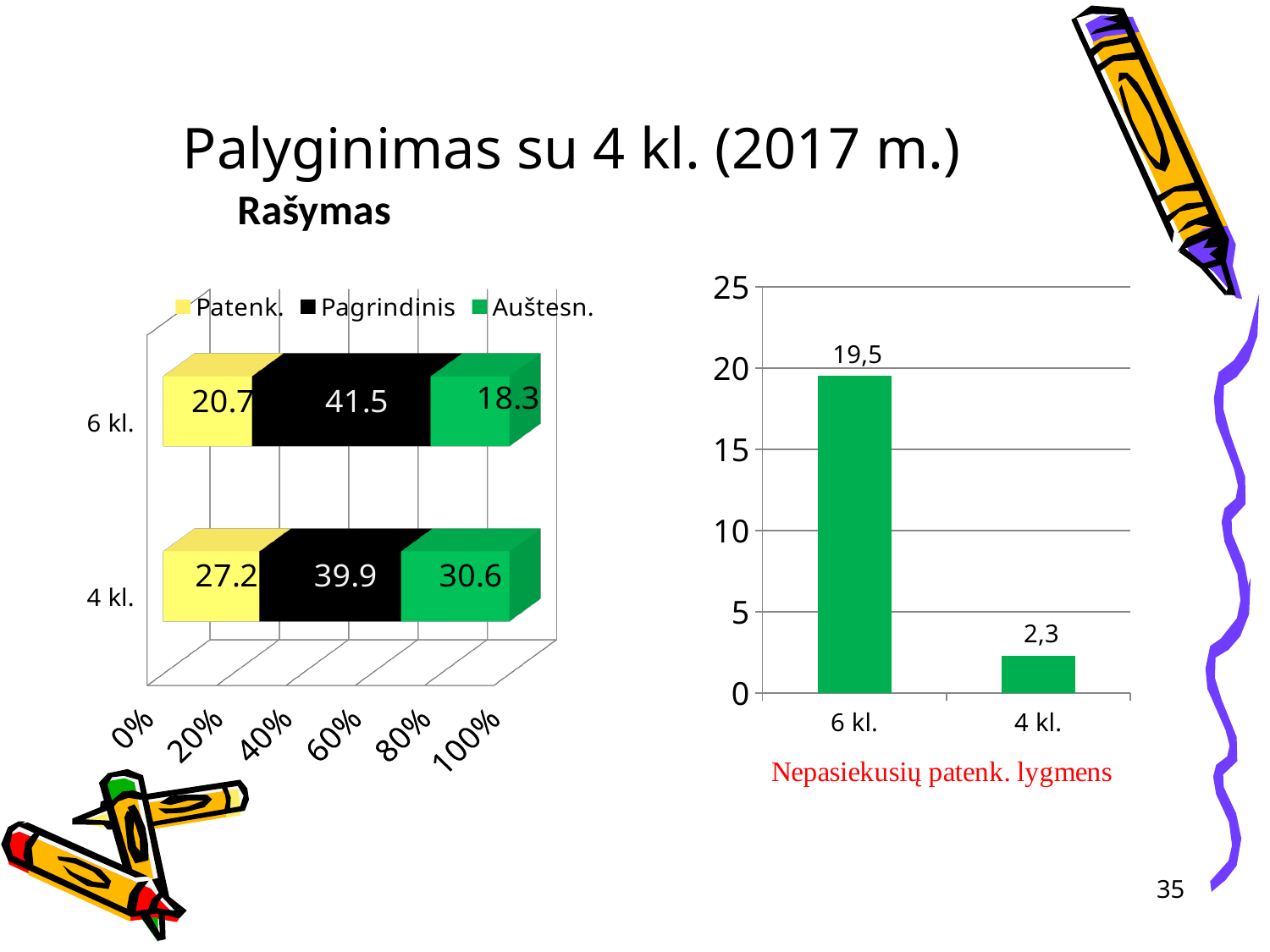
In the right chart (Nepasiekusių patenk. lygmens), what is the value for 4 kl.? 2,3 In the left stacked bar chart, which colour represents the Pagrindinis series? Black In the left stacked bar chart, what is the Auštesn. value for 4 kl.? 30.6 In the right chart (Nepasiekusių patenk. lygmens), which category has the lowest value? 4 kl. In the left stacked bar chart, what is the total of the three segments for the 4 kl. bar? 97.7 In the left stacked bar chart, what is the Patenk. value for 6 kl.? 20.7 In the left stacked bar chart, what is the difference between the Patenk. values for 4 kl. and 6 kl.? 6.5 In the right chart (Nepasiekusių patenk. lygmens), what is the value for 6 kl.? 19,5 In the left stacked bar chart, what is the Pagrindinis value for 6 kl.? 41.5 In the left stacked bar chart, which category has the higher Auštesn. value, 6 kl. or 4 kl.? 4 kl. What kind of chart is the right chart (Nepasiekusių patenk. lygmens)? Bar chart How many series does the legend of the left stacked bar chart list? 3